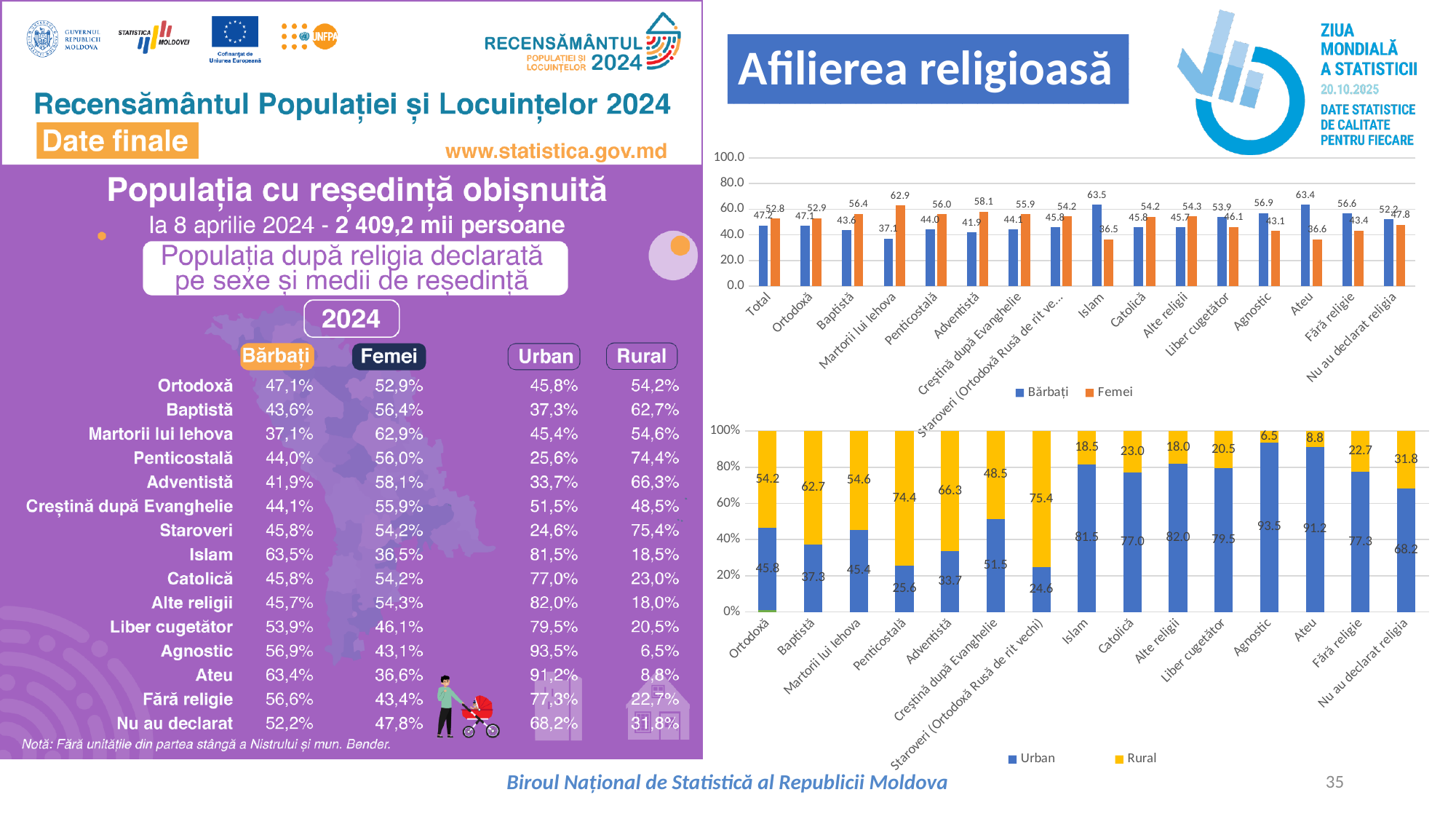
In the bottom chart on the right, how many categories are shown on the x axis? 15 In the bottom chart on the right, what is the Rural value for Staroveri (Ortodoxă Rusă de rit vechi)? 75.4 In the top chart on the right, what is the Bărbați value for Islam? 63.5 In the top chart on the right, which category has the highest Femei value? Martorii lui Iehova In the top chart on the right, what is the difference between the Femei and Bărbați values for Total? 5.6 In the bottom chart on the right, what is the Urban value for Agnostic? 93.5 In the top chart on the right, what is the Femei value for Martorii lui Iehova? 62.9 What type of chart is the bottom chart on the right? Stacked bar chart In the top chart on the right, how many series does the legend list? 2 In the top chart on the right, which category has the lowest Bărbați value? Martorii lui Iehova In the bottom chart on the right, which category has the lowest Urban value? Staroveri (Ortodoxă Rusă de rit vechi) In the bottom chart on the right, is the Urban value for Ateu larger or the Urban value for Catolică? Ateu